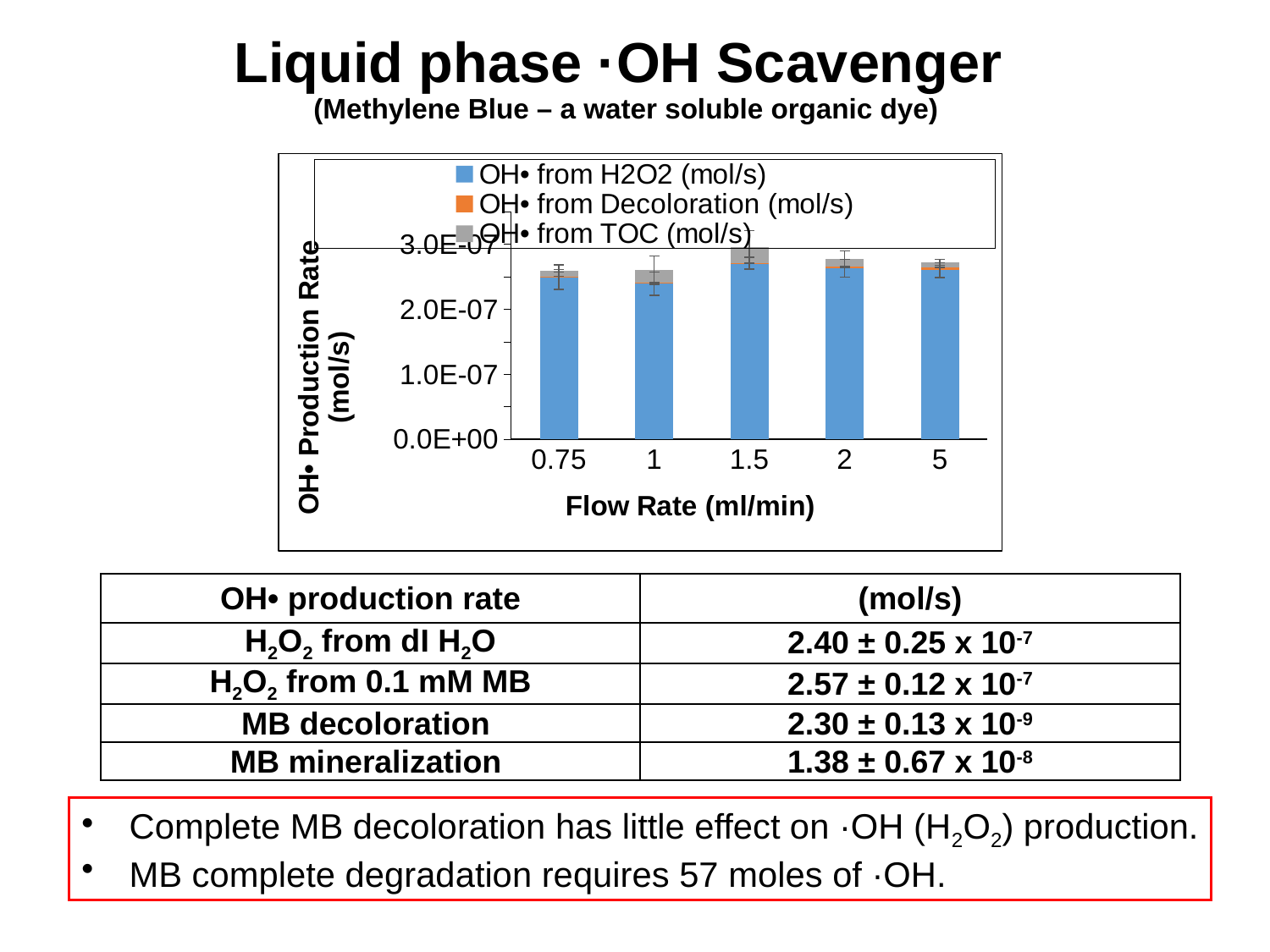
What colour represents the 'OH• from H2O2 (mol/s)' series in the chart? blue Which flow rate has the highest total stacked bar in the chart? 1.5 How many series does the chart's legend list? 3 How many flow rate categories are plotted on the x axis of the chart? 5 What is the title of the x axis of the chart? Flow Rate (ml/min) Is the total OH• production rate for the 5 ml/min flow rate greater or less than 3.0E-07? less Is the total OH• production rate for the 2 ml/min flow rate greater or less than 2.0E-07? greater Is the OH• from H2O2 value larger at a flow rate of 1.5 ml/min or at 1 ml/min? 1.5 Is the total OH• production rate for the 0.75 ml/min flow rate greater or less than 2.0E-07? greater What kind of chart is shown on the slide? bar chart